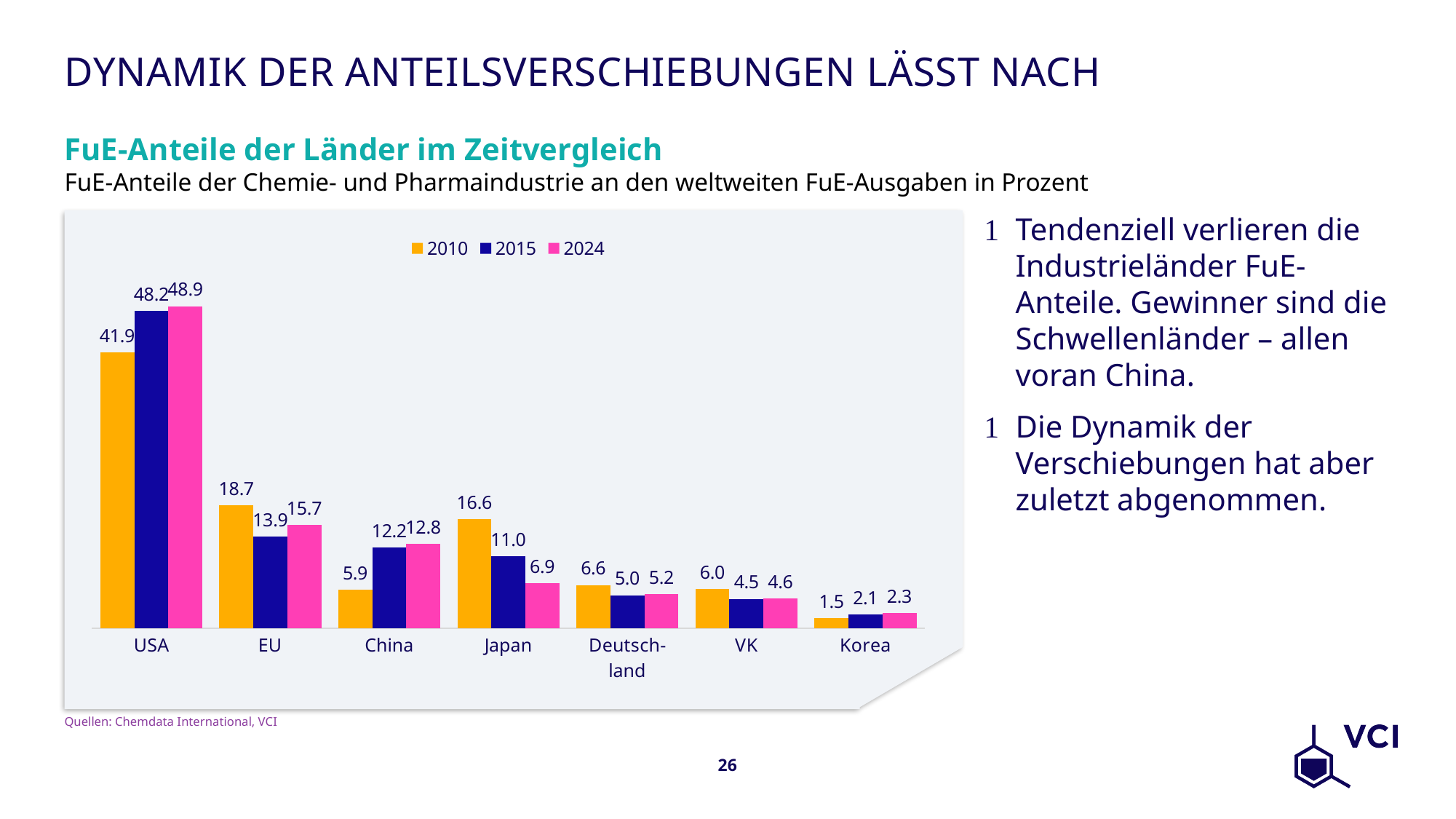
Which country has the lowest value in 2010? Korea What is the value for China in 2010? 5.9 How many countries or regions are shown on the x axis? 7 Which is larger, the 2024 value for EU or the 2024 value for China? EU What kind of chart is shown? Bar chart How many series does the legend list? 3 What is the difference between the 2024 and 2010 values for China? 6.9 Which year is shown in pink in the legend? 2024 Which country has the highest value in 2024? USA What is the value for USA in 2024? 48.9 What is the value for Japan in 2015? 11.0 What is the difference between the 2010 and 2024 values for Japan? 9.7